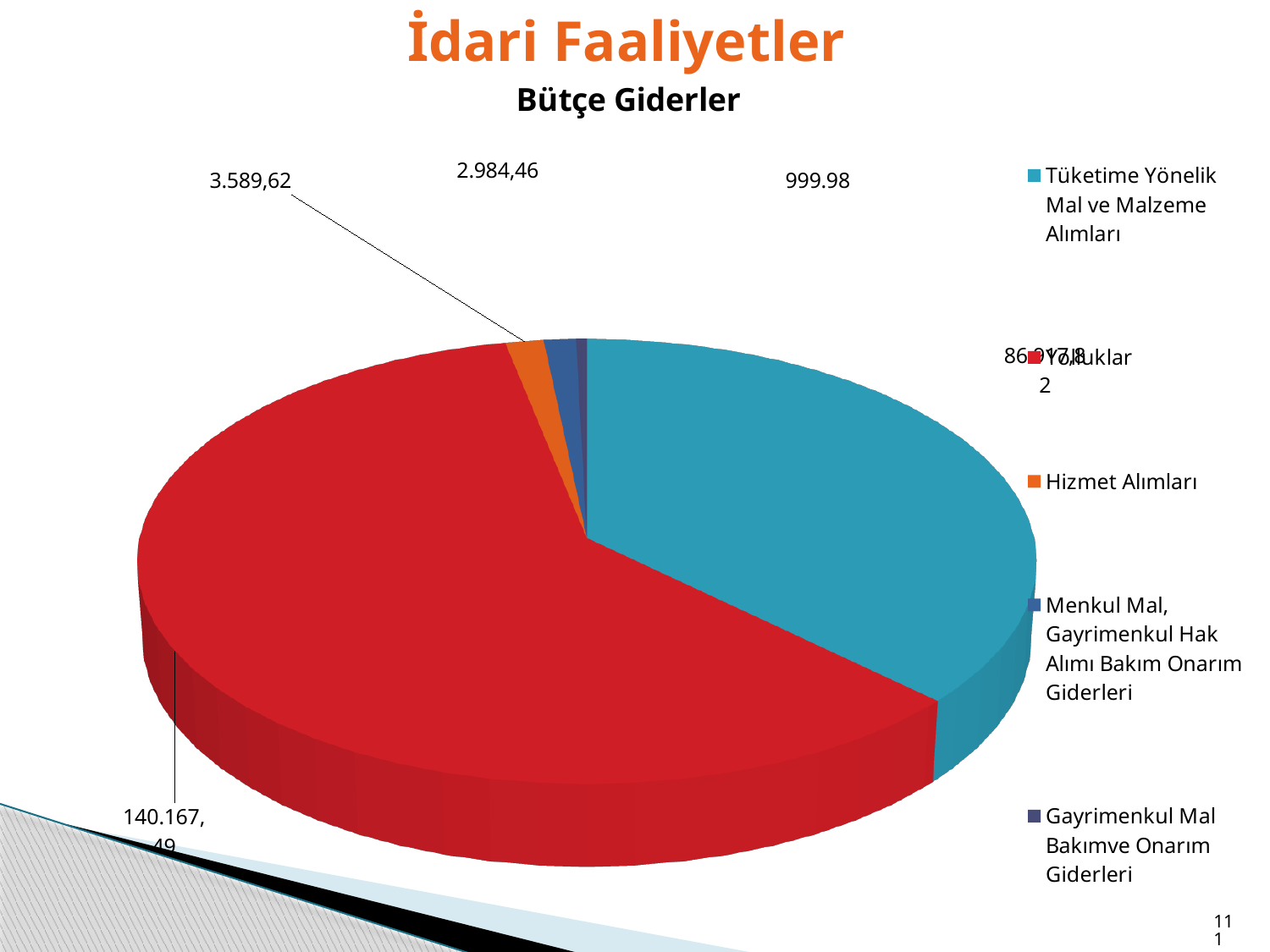
What colour is the slice for Yolluklar? red What is the title of the pie chart? Bütçe Giderler What is the value shown for Yolluklar? 140.167,49 Which category has the smallest slice of the pie chart? Gayrimenkul Mal Bakımve Onarım Giderleri How many categories does the legend of the pie chart list? 5 What kind of chart is shown on the slide? pie chart Which category has the largest slice of the pie chart? Yolluklar What is the value shown for Menkul Mal, Gayrimenkul Hak Alımı Bakım Onarım Giderleri? 2.984,46 Which is larger, the value for Hizmet Alımları or the value for Menkul Mal, Gayrimenkul Hak Alımı Bakım Onarım Giderleri? Hizmet Alımları What is the value shown for Hizmet Alımları? 3.589,62 What is the value shown for Gayrimenkul Mal Bakımve Onarım Giderleri? 999.98 Which is larger, the slice for Yolluklar or the slice for Tüketime Yönelik Mal ve Malzeme Alımları? Yolluklar